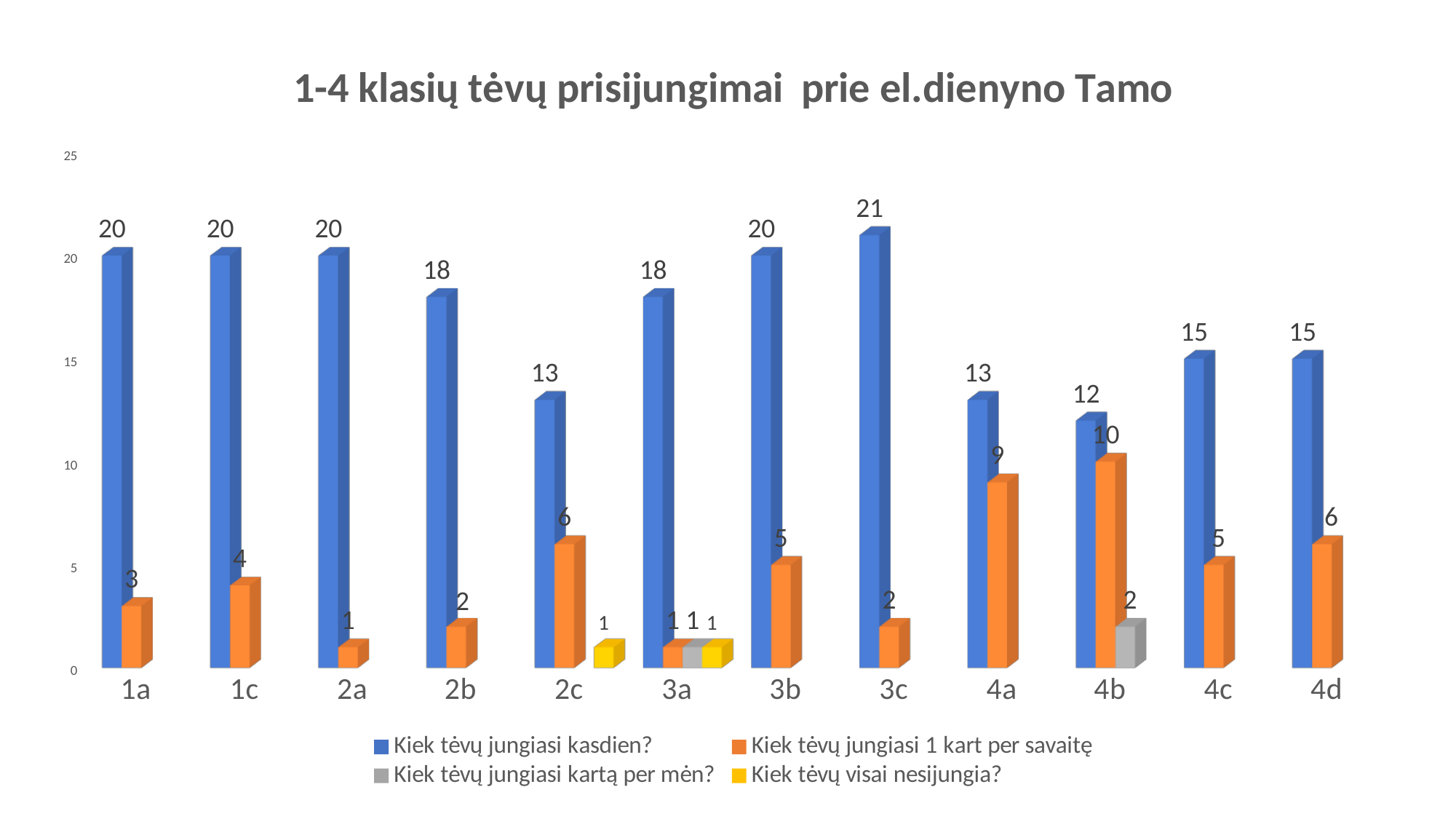
What is the value of 'Kiek tėvų visai nesijungia?' for class 2c? 1 What is the value of 'Kiek tėvų jungiasi kartą per mėn?' for class 4b? 2 What type of chart is shown on the slide? bar chart What is the value of 'Kiek tėvų jungiasi kasdien?' for class 3c? 21 Which class has the highest value for 'Kiek tėvų jungiasi kasdien?'? 3c What is the difference between the 'Kiek tėvų jungiasi kasdien?' values for class 3c and class 4b? 9 Which class has the lowest value for 'Kiek tėvų jungiasi kasdien?'? 4b Which is larger: the 'Kiek tėvų jungiasi 1 kart per savaitę' value for class 4a or for class 2c? 4a How many classes (categories) are shown on the x axis? 12 How many series does the legend list? 4 What is the value of 'Kiek tėvų jungiasi 1 kart per savaitę' for class 4b? 10 What is the title of the chart? 1-4 klasių tėvų prisijungimai prie el.dienyno Tamo